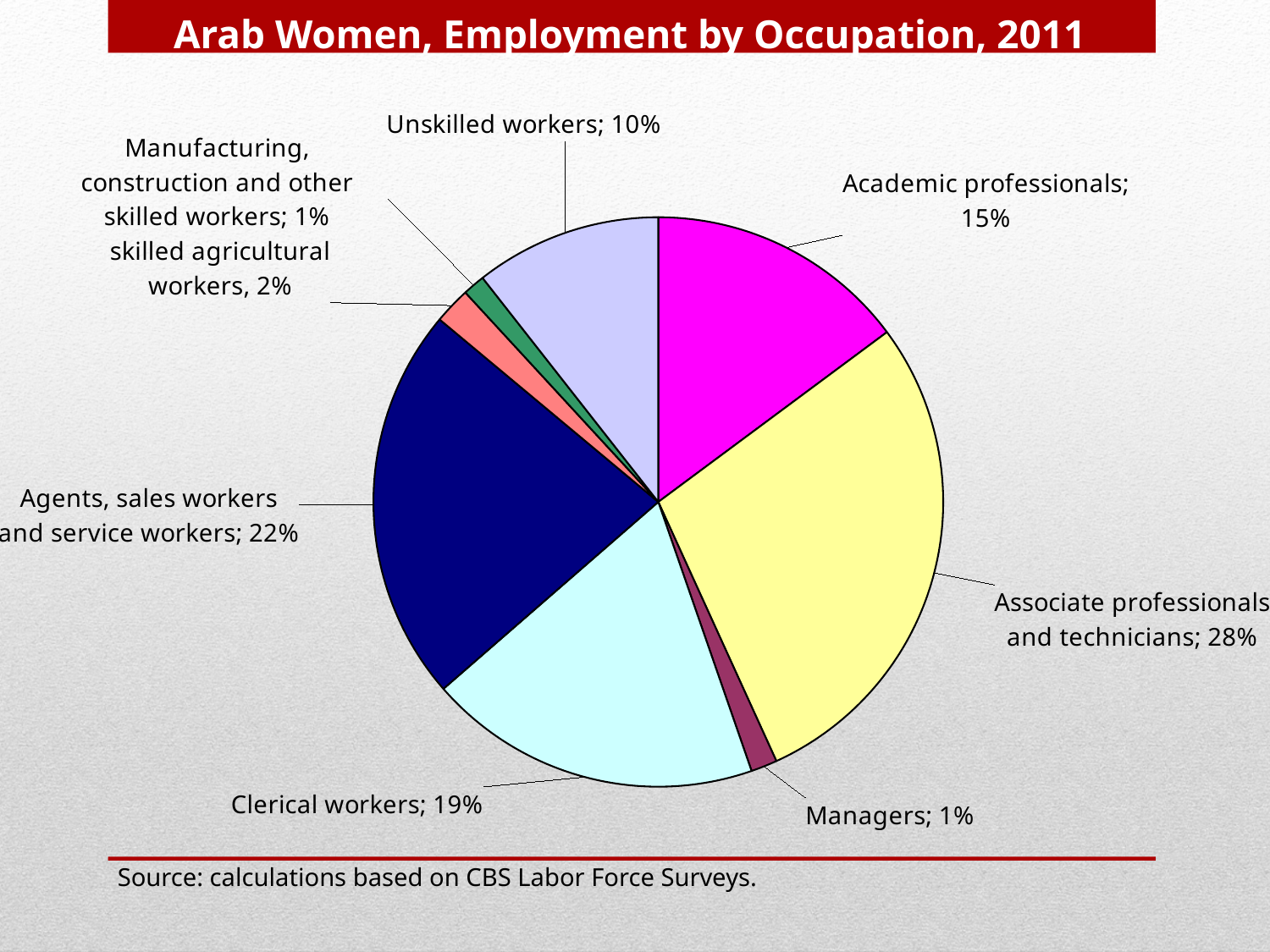
What is the value for Agents, sales workers and service workers? 22% What is the value for Academic professionals? 15% Which is larger, the share for Academic professionals or the share for Unskilled workers? Academic professionals What is the difference between the shares for Agents, sales workers and service workers and Clerical workers? 3% What share of the pie is Clerical workers? 19% What is the value for skilled agricultural workers? 2% Which occupation has the largest share of the pie? Associate professionals and technicians How many slices does the pie chart have? 8 What share of the pie is Associate professionals and technicians? 28% What is the title of the chart? Arab Women, Employment by Occupation, 2011 What type of chart is shown on the slide? pie chart What is the value for Unskilled workers? 10%